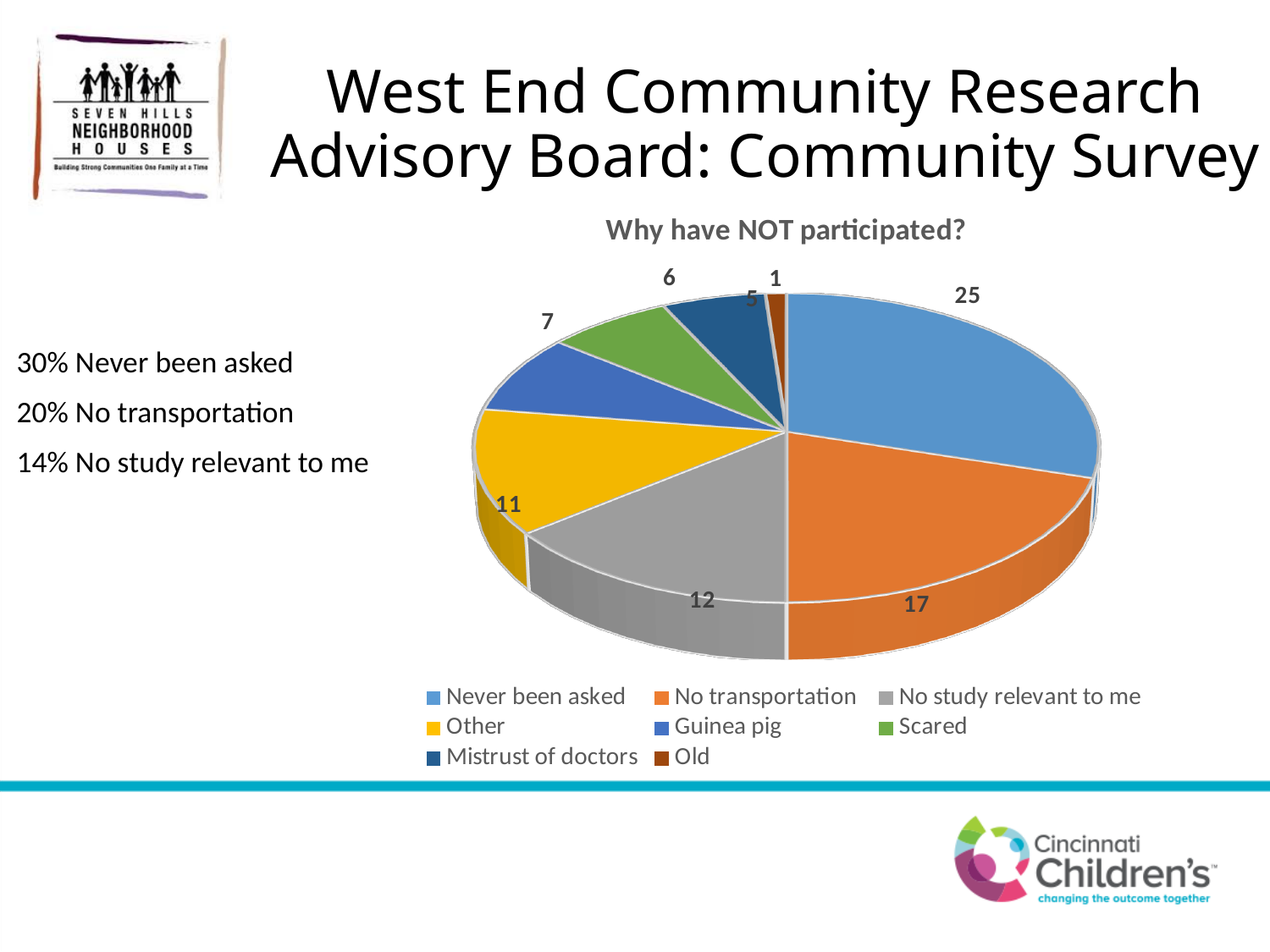
What share of the pie does "Never been asked" represent, according to the slide? 30% Which category has the smallest slice? Old What kind of chart is shown on the slide? pie chart How many categories does the legend list? 8 What is the title of the chart? Why have NOT participated? Which is larger, the value for "Other" or the value for "Scared"? Other What is the value for "Never been asked"? 25 What is the value for "No transportation"? 17 What is the difference between the values for "No transportation" and "No study relevant to me"? 5 What is the value for "Guinea pig"? 7 What is the value for "Mistrust of doctors"? 5 Which category has the largest slice? Never been asked